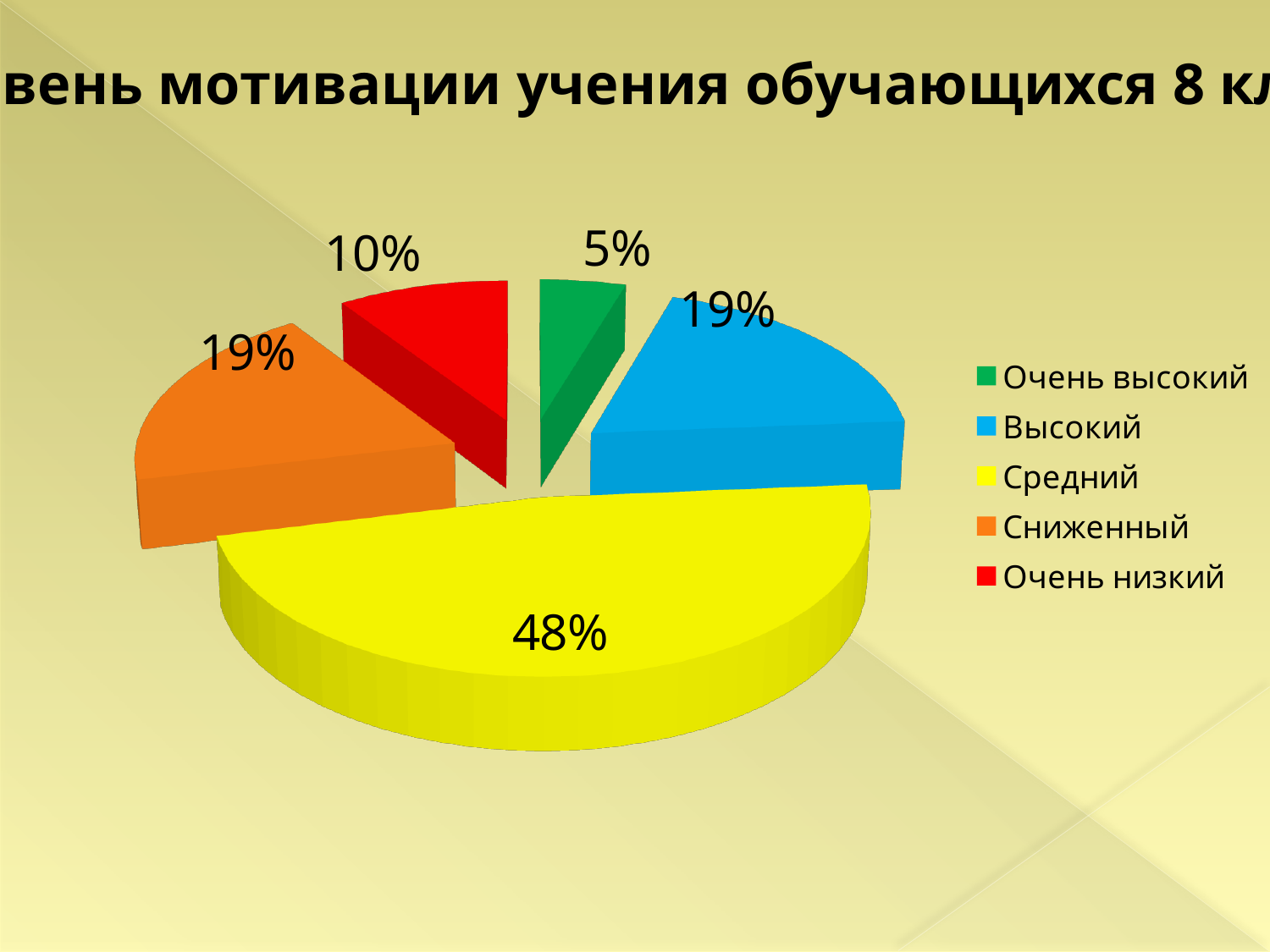
What percentage is shown for the Средний slice? 48% What is the difference in percentage points between the Средний slice and the Очень низкий slice? 38 What percentage is shown for the Очень высокий slice? 5% Which category has the smallest share of the pie? Очень высокий Which is larger, the Сниженный slice or the Очень низкий slice? Сниженный What colour is the Сниженный slice? orange How many slices does the pie chart have? 5 What percentage is shown for the Очень низкий slice? 10% Which category has the largest share of the pie? Средний What percentage is shown for the Высокий slice? 19% What kind of chart is shown on the slide? pie chart How many entries does the legend list? 5